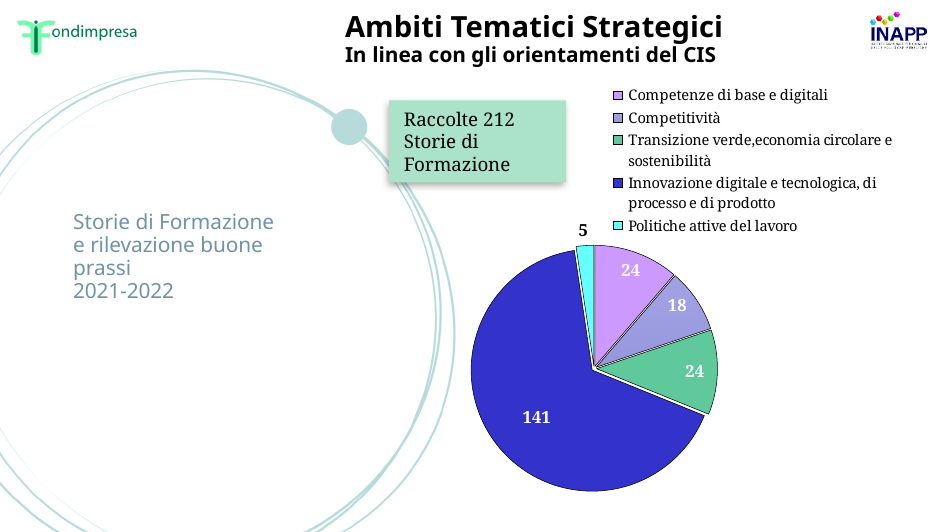
Which is larger in the pie chart: 'Competitività' or 'Competenze di base e digitali'? Competenze di base e digitali What is the difference between the values for 'Innovazione digitale e tecnologica, di processo e di prodotto' and 'Competitività'? 123 How many entries does the legend of the pie chart list? 5 What is the value for 'Innovazione digitale e tecnologica, di processo e di prodotto' in the pie chart? 141 Which category has the smallest slice in the pie chart? Politiche attive del lavoro How many slices does the pie chart have? 5 What is the value for 'Transizione verde, economia circolare e sostenibilità' in the pie chart? 24 What is the total of all the values shown in the pie chart? 212 What is the value for 'Politiche attive del lavoro' in the pie chart? 5 Which category has the largest slice in the pie chart? Innovazione digitale e tecnologica, di processo e di prodotto What is the value for 'Competitività' in the pie chart? 18 What type of chart is shown on the slide? pie chart